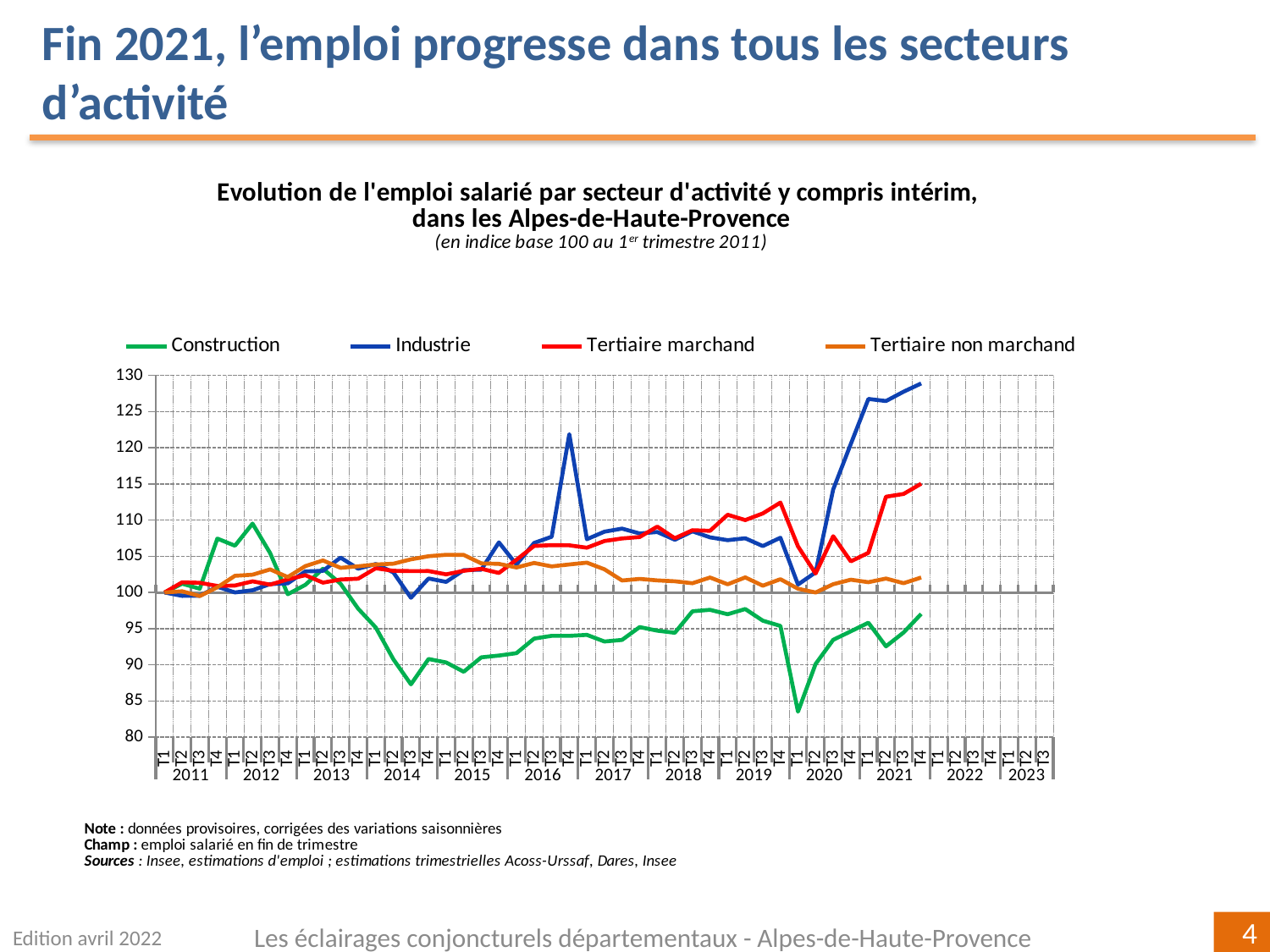
Does the Industrie series rise or fall between T2 2020 and T4 2021? rise What is the index value of all four series at T1 2011? 100 Is the value for Construction at T1 2020 greater or less than 85? less Is the value for Tertiaire non marchand at T4 2021 greater or less than 105? less What kind of chart is shown on the slide? line chart How many series does the legend list? 4 Which series has the highest value at T4 2021? Industrie Which series is shown in green in the legend? Construction Which series has the lowest value at T4 2021? Construction Is the value for Industrie at T4 2021 greater or less than 125? greater What is the base period of the index used in the chart, according to the subtitle? 1er trimestre 2011